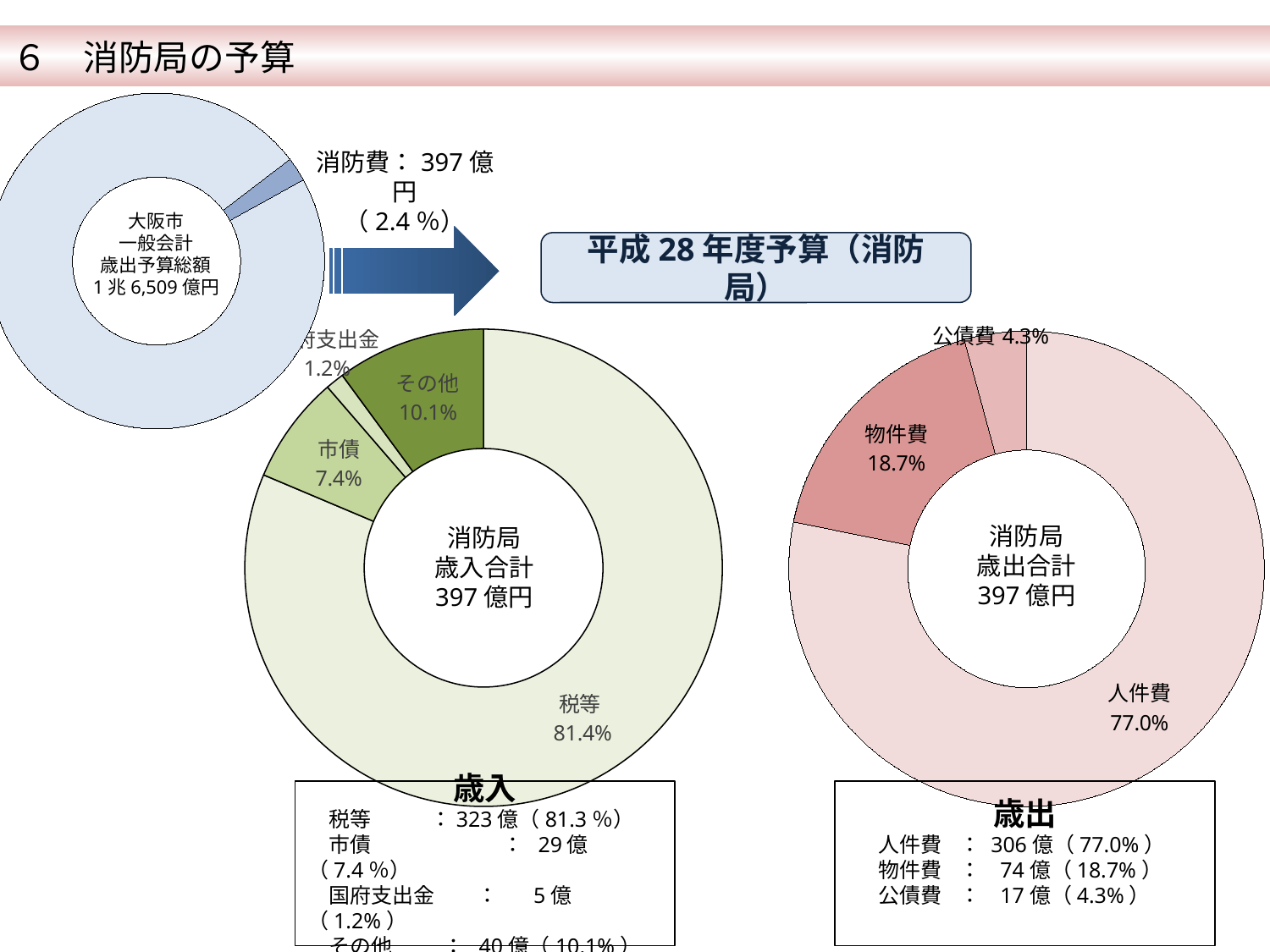
On the 消防局歳入合計 donut chart (middle), which category has the smallest share? 国府支出金 On the 消防局歳出合計 donut chart (right), what percentage is shown for 物件費? 18.7% On the top-left donut chart, what percentage of the 大阪市一般会計歳出予算総額 is 消防費? 2.4% How many categories are shown on the 消防局歳入合計 donut chart (middle)? 4 On the 消防局歳出合計 donut chart (right), which category has the largest share? 人件費 On the 消防局歳出合計 donut chart (right), what percentage is shown for 公債費? 4.3% On the 消防局歳入合計 donut chart (middle), which is larger, その他 or 市債? その他 What kind of chart is used for 消防局歳出合計 on the right? Donut (pie) chart On the 消防局歳出合計 donut chart (right), what is the difference in percentage points between 人件費 and 物件費? 58.3 On the 消防局歳入合計 donut chart (middle), what percentage is shown for 市債? 7.4% On the 消防局歳入合計 donut chart (middle), what percentage is shown for その他? 10.1% How many categories are shown on the 消防局歳出合計 donut chart (right)? 3